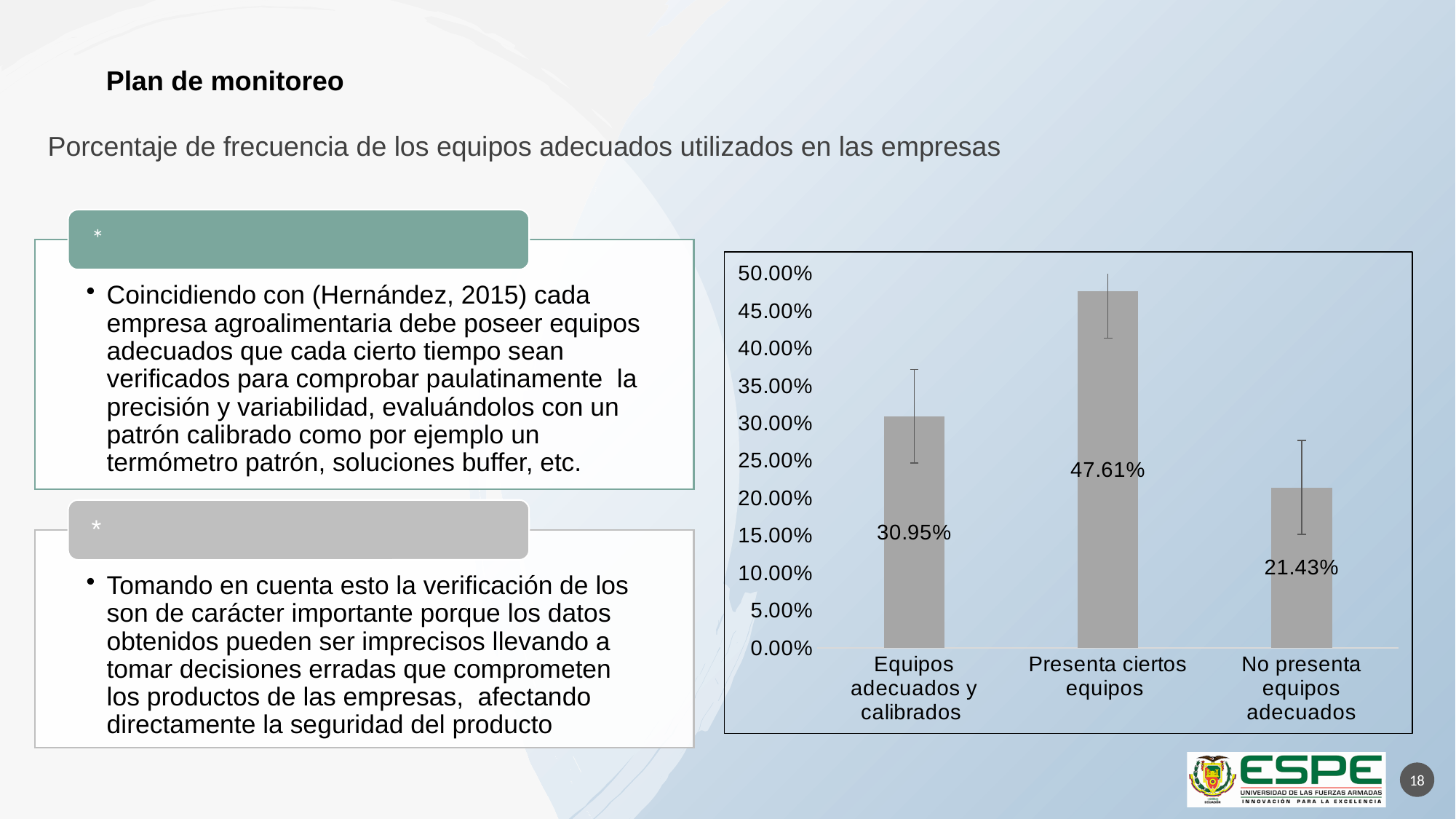
Which category has the lowest value? No presenta equipos adecuados What is the value for "No presenta equipos adecuados"? 21.43% Is the value for "Presenta ciertos equipos" greater or less than 40.00%? greater Which is larger, the value for "Equipos adecuados y calibrados" or the value for "No presenta equipos adecuados"? Equipos adecuados y calibrados What kind of chart is shown on the slide? Bar chart Which category has the highest value? Presenta ciertos equipos What is the difference between the values for "Equipos adecuados y calibrados" and "No presenta equipos adecuados"? 9.52% What is the highest value shown on the chart's vertical axis? 50.00% What is the value for "Presenta ciertos equipos"? 47.61% What is the value for "Equipos adecuados y calibrados"? 30.95% How many categories are shown on the x axis of the chart? 3 What is the difference between the values for "Presenta ciertos equipos" and "Equipos adecuados y calibrados"? 16.66%